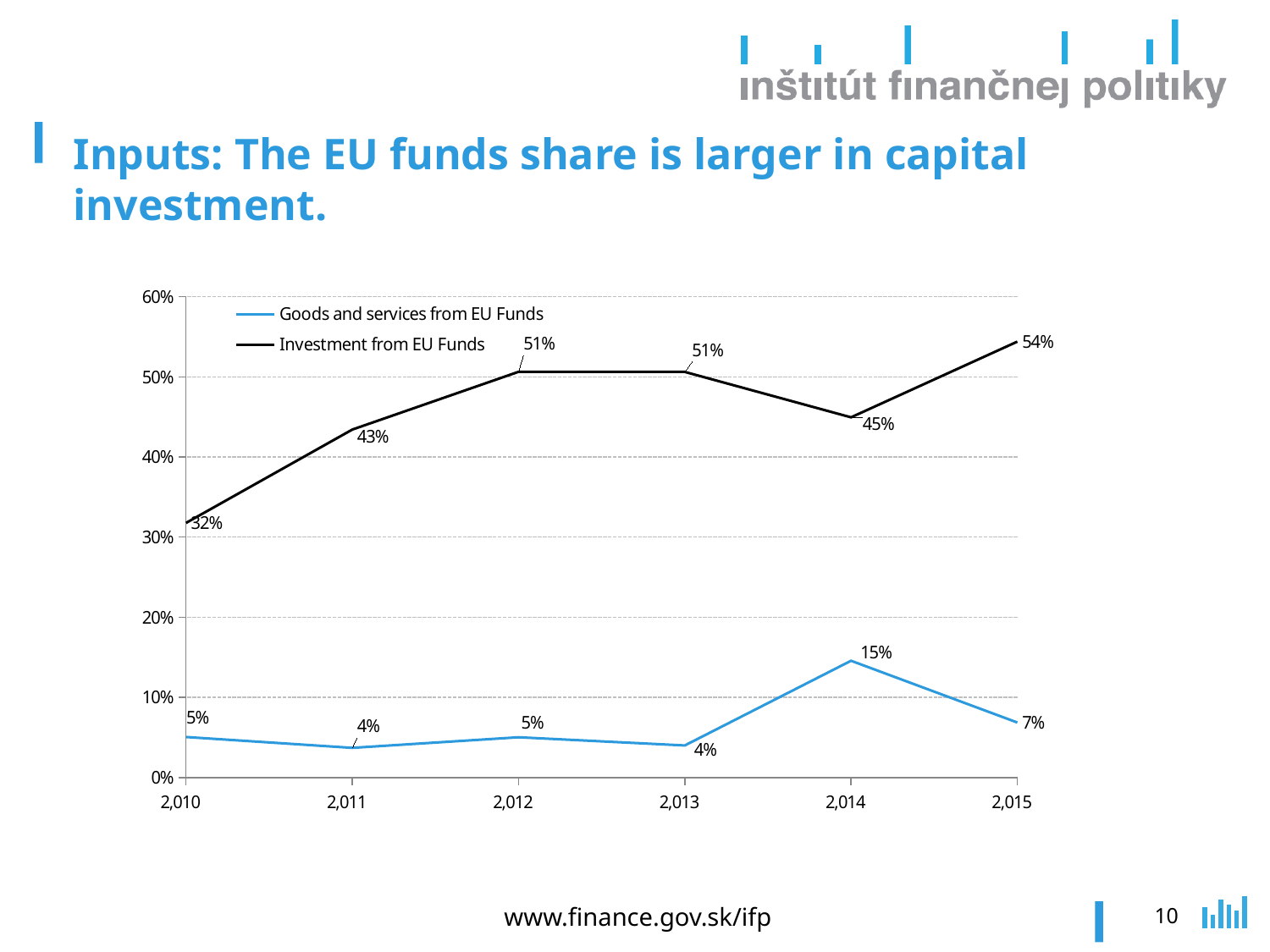
What is the value for Investment from EU Funds in 2,010? 32% How many series does the legend list? 2 In which year is Investment from EU Funds lowest? 2,010 How many years are shown on the x axis? 6 Which is larger in 2,014: Investment from EU Funds or Goods and services from EU Funds? Investment from EU Funds In which year is Goods and services from EU Funds highest? 2,014 What kind of chart is shown on the slide? line chart What is the value for Goods and services from EU Funds in 2,014? 15% What is the value for Investment from EU Funds in 2,015? 54% Is the value for Investment from EU Funds in 2,013 greater or less than 40%? greater What is the difference between Investment from EU Funds and Goods and services from EU Funds in 2,015? 47% Does Investment from EU Funds rise or fall from 2,010 to 2,012? rise